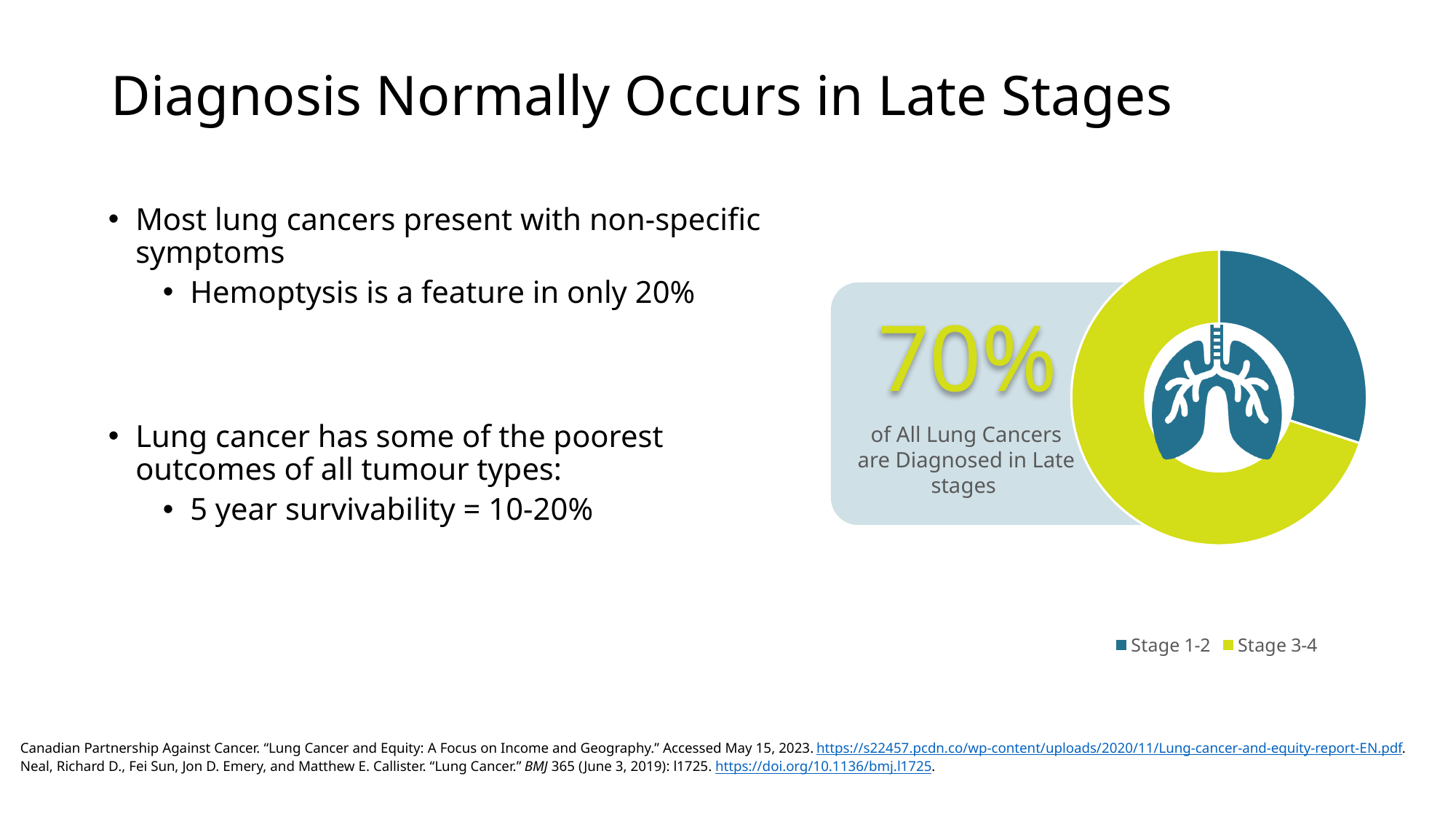
Which is larger in the pie chart, Stage 1-2 or Stage 3-4? Stage 3-4 How many slices does the pie chart have? 2 What colour represents Stage 1-2 in the pie chart? Blue (teal) Is the share for Stage 3-4 greater or less than 50%? greater How many series does the chart legend list? 2 What kind of chart is shown on the slide? Pie chart (donut) Which slice of the pie chart is the largest? Stage 3-4 Is the share for Stage 1-2 greater or less than 50%? less What share of all lung cancers are diagnosed in late stages (Stage 3-4) according to the slide? 70% Which slice of the pie chart is the smallest? Stage 1-2 What colour represents Stage 3-4 in the pie chart? Green (yellow-green)